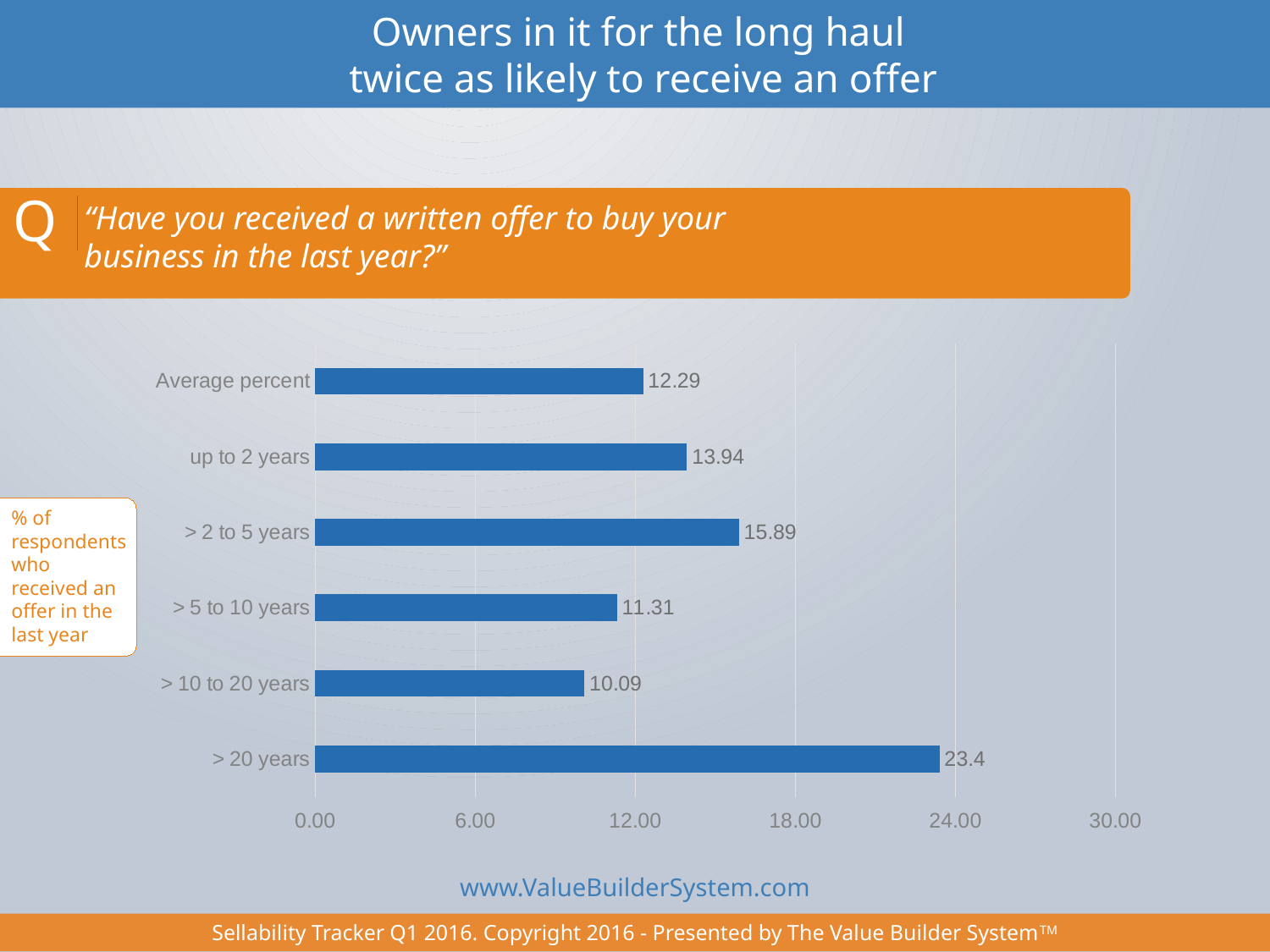
What kind of chart is shown on the slide? bar chart Which category has the highest value? > 20 years What is the value for 'Average percent'? 12.29 What is the value for 'up to 2 years'? 13.94 What is the value for '> 5 to 10 years'? 11.31 Is the value for '> 20 years' greater or less than 18.00? greater Which is larger, the value for '> 2 to 5 years' or the value for 'up to 2 years'? > 2 to 5 years How many categories are shown in the chart? 6 What is the maximum value shown on the x axis? 30.00 Which category has the lowest value? > 10 to 20 years What is the difference between the values for '> 20 years' and '> 10 to 20 years'? 13.31 What is the value for '> 20 years'? 23.4